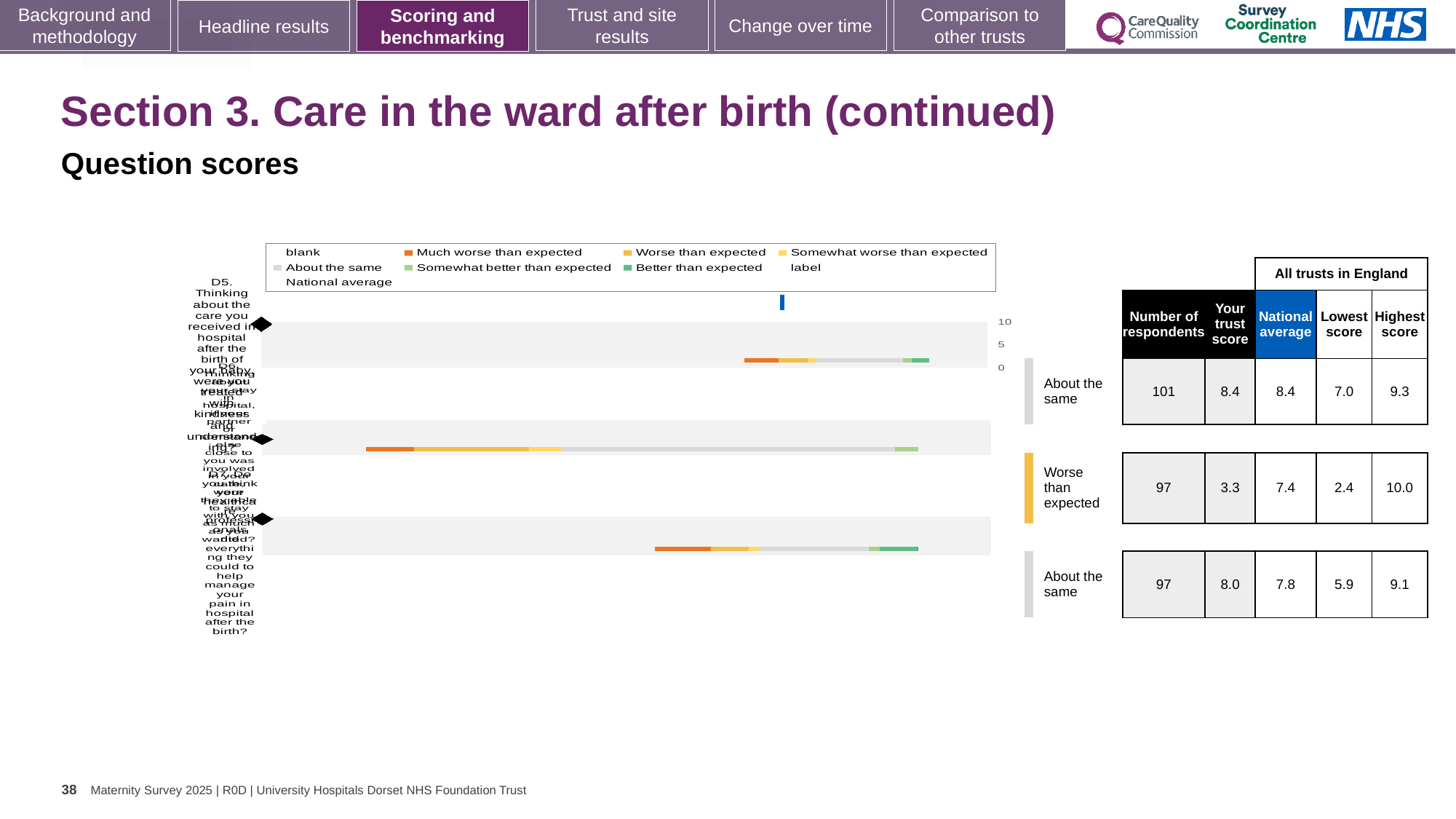
In the table, how many respondents are listed for the row marked 'Worse than expected'? 97 How many of the three rows are marked 'About the same'? 2 In the table, which has the larger 'Your trust score': the first row or the third row? the first row In the table, what is the highest score for the row marked 'Worse than expected'? 10.0 In the table, which row has the lowest value in the 'Lowest score' column? the row marked 'Worse than expected' How many question bars are plotted in the chart? 3 In the table, what is the lowest score for the third row (the second 'About the same' row)? 5.9 In the table, what is the difference between the national average and 'Your trust score' for the row marked 'Worse than expected'? 4.1 In the table, what is the national average for the first row (the first 'About the same' row)? 8.4 What kind of chart is shown on the slide? bar chart In the table, which row has the highest value in the 'Highest score' column? the row marked 'Worse than expected' In the table, what is 'Your trust score' for the row marked 'Worse than expected'? 3.3